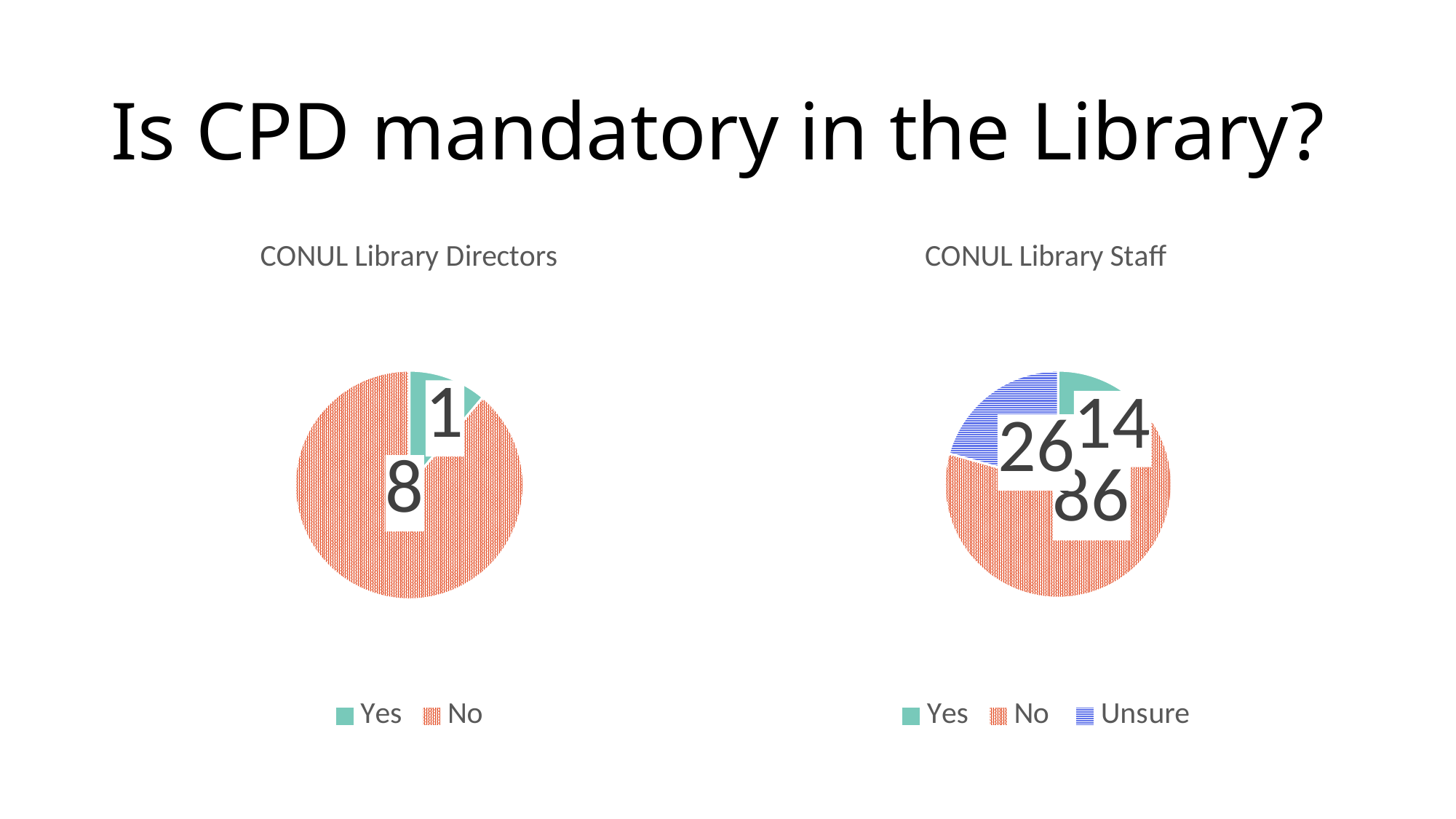
How many entries does the legend of the CONUL Library Directors chart list? 2 In the CONUL Library Directors chart, how many directors answered No? 8 How many categories does the CONUL Library Staff chart show? 3 In the CONUL Library Directors chart, how many directors answered Yes? 1 In the CONUL Library Staff chart, how many staff answered Yes? 14 In the CONUL Library Staff chart, which response has the smallest slice? Yes What type of chart is the CONUL Library Directors chart? Pie chart In the CONUL Library Staff chart, how many staff answered Unsure? 26 In the CONUL Library Staff chart, which response has the largest slice? No In the CONUL Library Staff chart, is the Unsure slice larger or smaller than the Yes slice? larger In the CONUL Library Directors chart, what is the difference between the No and Yes counts? 7 What is the title of the chart on the right of the slide? CONUL Library Staff